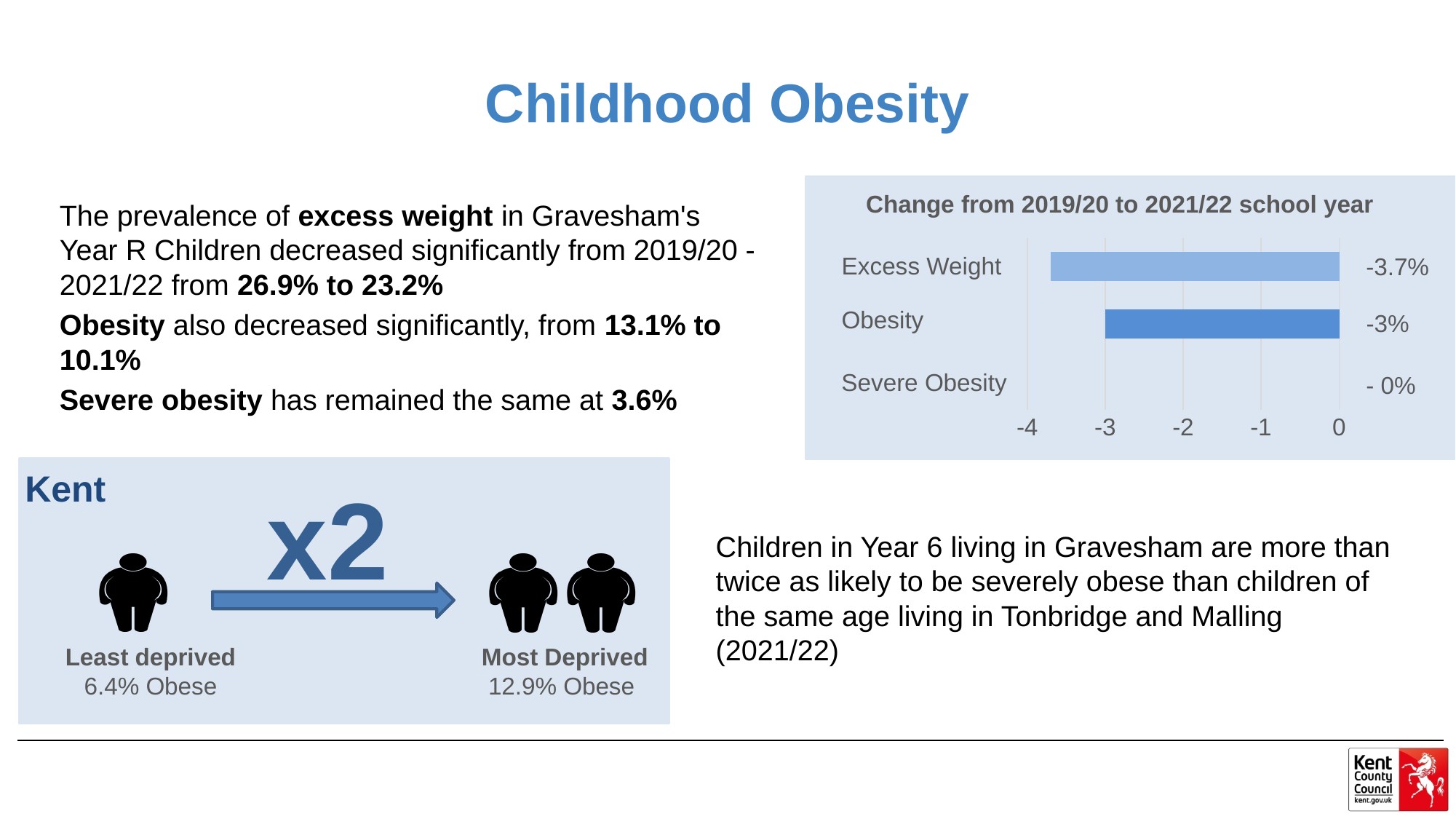
Which has a larger decrease in the chart, Excess Weight or Obesity? Excess Weight What is the lowest value shown on the chart's x axis? -4 What is the difference between the Excess Weight change and the Obesity change in the chart? 0.7% What is the title of the chart on the slide? Change from 2019/20 to 2021/22 school year What is the value shown for Obesity in the chart? -3% What is the value shown for Excess Weight in the chart? -3.7% Which category in the chart shows the largest decrease? Excess Weight How many categories are shown in the chart? 3 Is the change for Excess Weight greater or less than -3 on the axis? less Which category in the chart shows no change? Severe Obesity What is the value shown for Severe Obesity in the chart? 0% What kind of chart is shown on the slide? bar chart